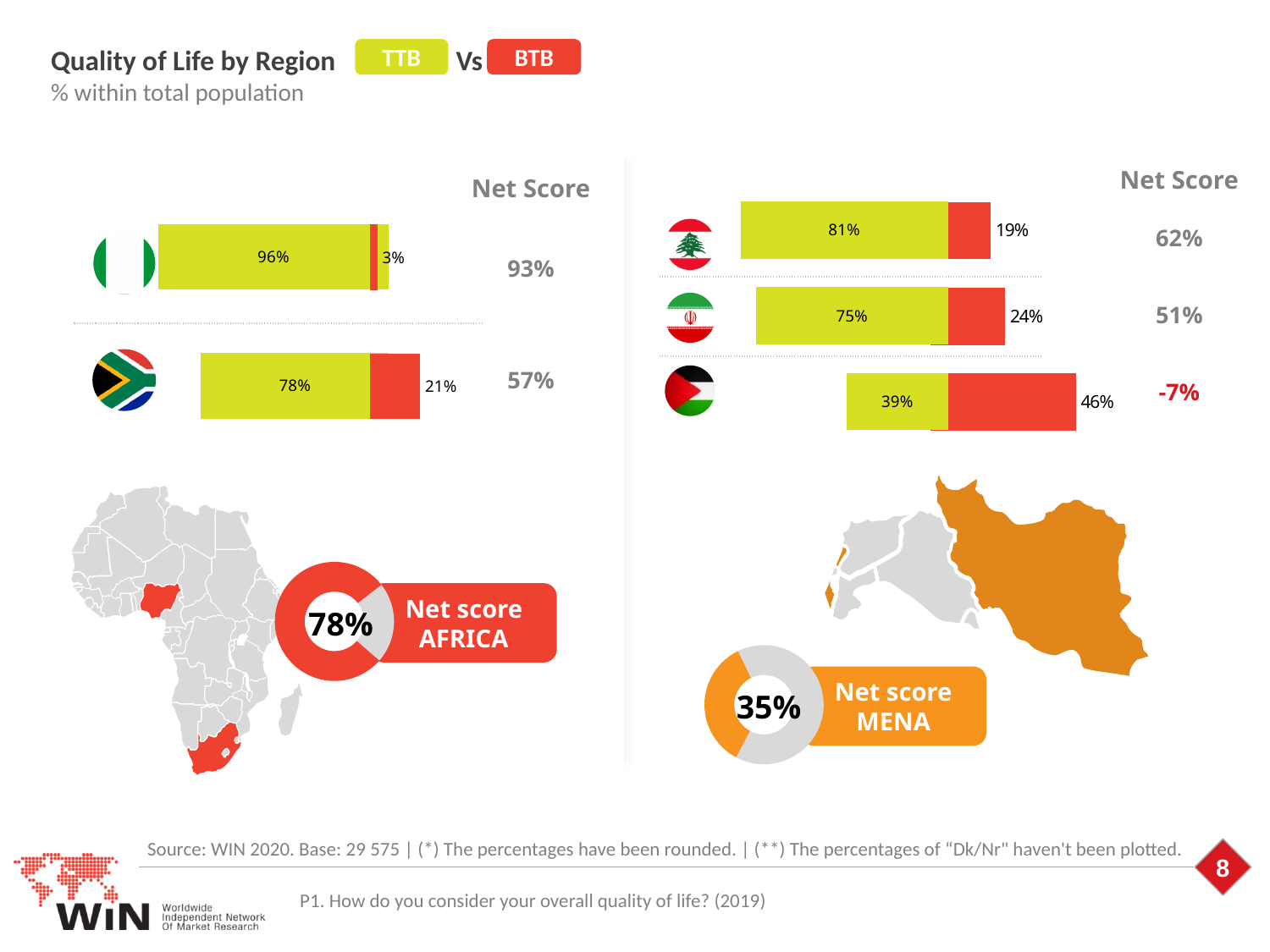
On the right chart (MENA), what is the TTB value for the top bar? 81% On the left chart (Africa), what is the TTB value for the top bar? 96% On the left chart (Africa), what is the BTB value for the second bar? 21% What value is shown in the Net score MENA donut chart? 35% On the left chart (Africa), which bar has the higher TTB value, the top bar or the second bar? The top bar What kind of chart is used to show the TTB vs BTB values for each country? Stacked bar chart On the left chart (Africa), what is the Net Score shown for the second bar? 57% On the right chart (MENA), what is the difference between the TTB values of the top bar and the second bar? 6% What value is shown in the Net score AFRICA donut chart? 78% On the right chart (MENA), what is the BTB value for the third bar? 46% How many bars are plotted on the right chart (MENA)? 3 On the right chart (MENA), which bar has the lowest Net Score? The third (bottom) bar, -7%